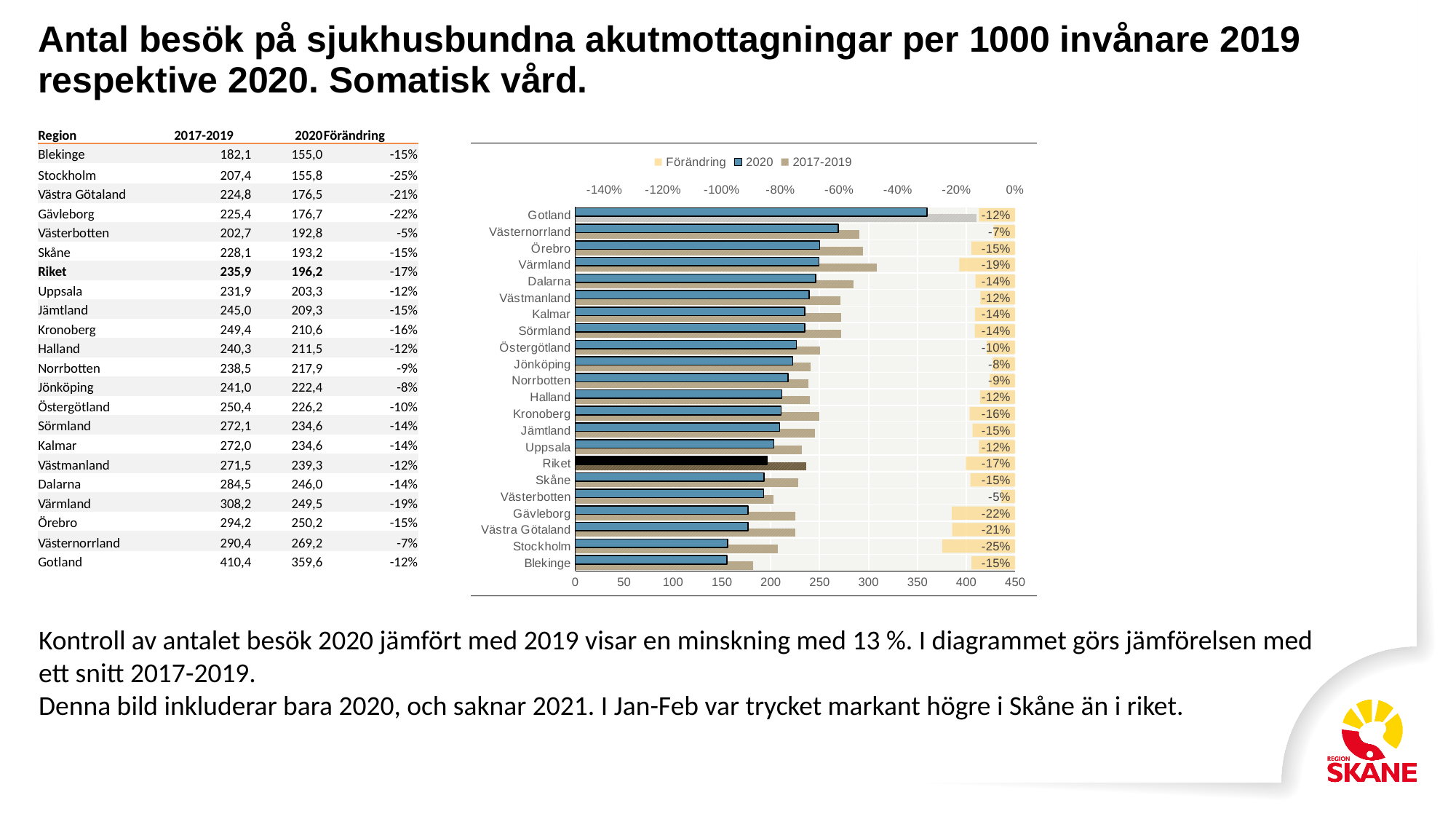
Which region has the most negative Förändring value? Stockholm What is the Förändring value shown for Riket? -17% What is the difference between the Förändring values for Stockholm and Västerbotten? 20 percentage points Which region has the smallest decrease (least negative Förändring value)? Västerbotten Is the 2020 value for Gotland greater or less than 300? greater Which region has the longer 2020 bar, Gotland or Stockholm? Gotland How many regions (categories) are plotted on the chart? 22 Is the 2020 value for Blekinge greater or less than 200? less What is the Förändring value shown for Västerbotten? -5% How many series does the legend list? 3 What is the Förändring value shown for Stockholm? -25% What kind of chart is shown? Bar chart